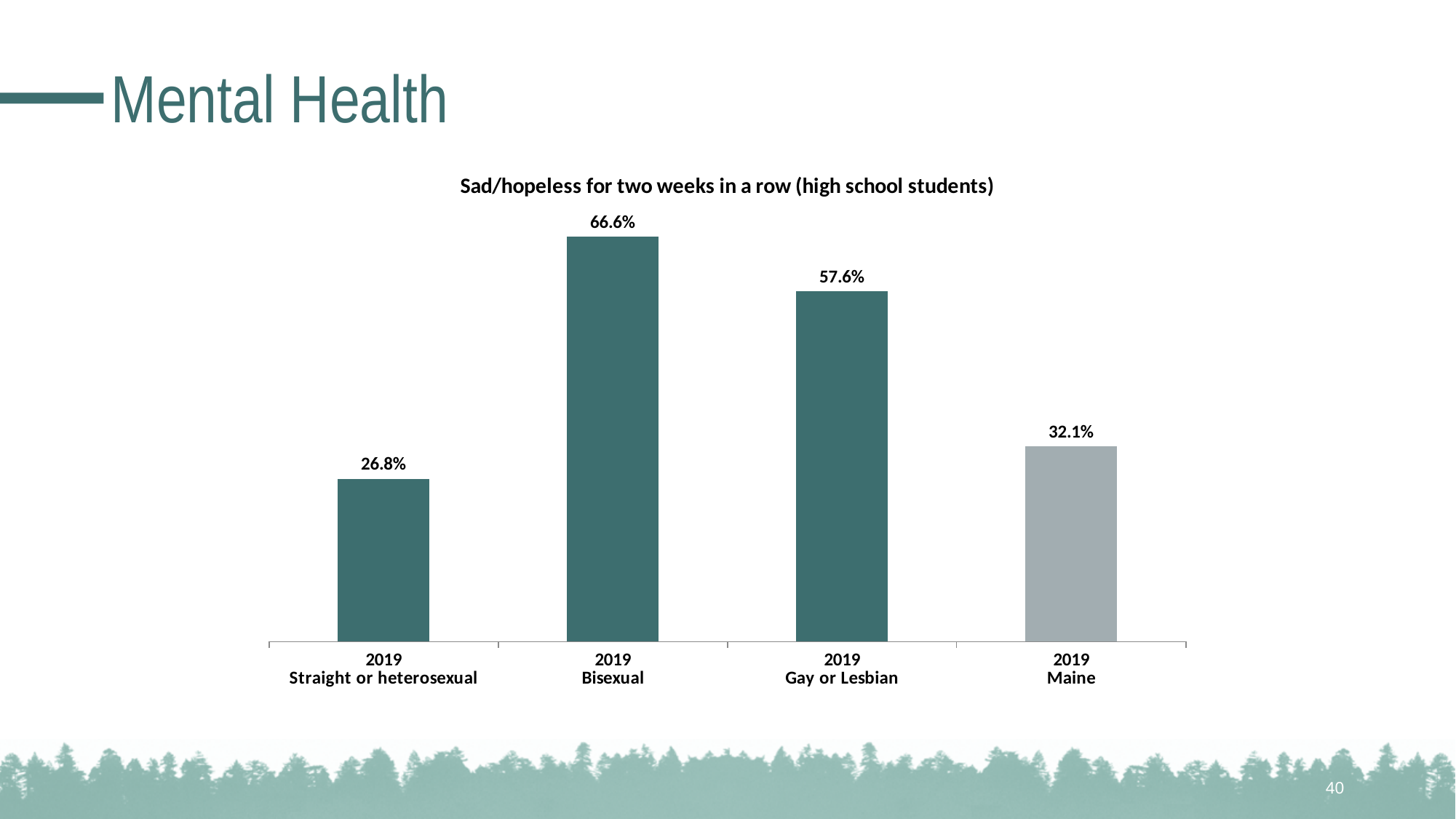
What is the value for Bisexual students in the chart? 66.6% What is the difference between the Bisexual and Gay or Lesbian values? 9.0% What is the value for Gay or Lesbian students? 57.6% Which category has the highest value? Bisexual What kind of chart is shown on the slide? Bar chart How many bars are shown in the chart? 4 What is the title of the chart? Sad/hopeless for two weeks in a row (high school students) What is the difference between the Maine value and the Straight or heterosexual value? 5.3% Which is larger, the value for Gay or Lesbian or the value for Maine? Gay or Lesbian What is the value for Maine overall? 32.1% Which category has the lowest value? Straight or heterosexual What is the value for Straight or heterosexual students? 26.8%